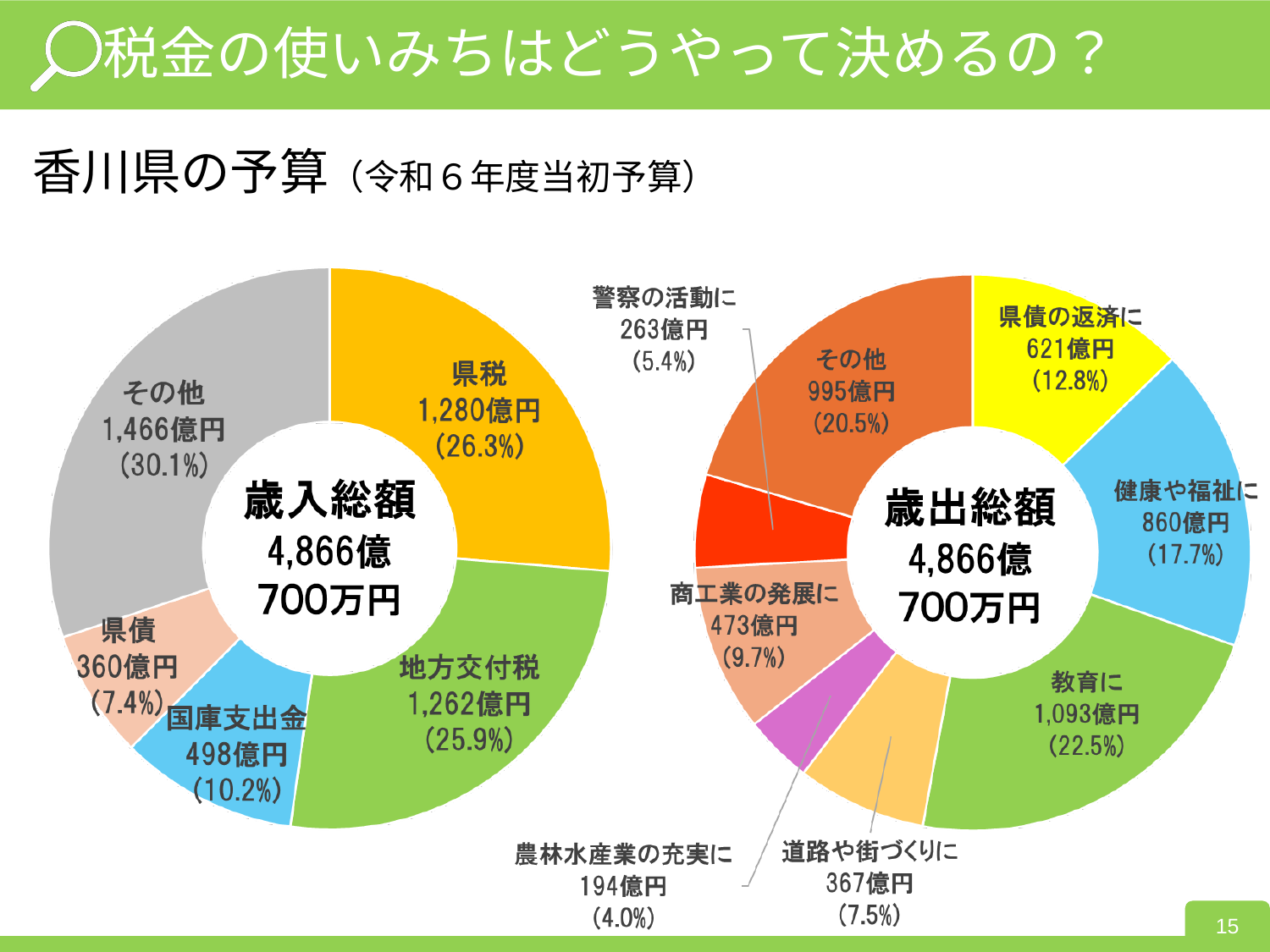
In the 歳入総額 chart on the left, which category has the largest value? その他 In the 歳入総額 chart on the left, what is the value for 県税? 1,280億円 In the 歳入総額 chart on the left, which category has the smallest value? 県債 In the 歳出総額 chart on the right, which category has the smallest value? 農林水産業の充実に In the 歳出総額 chart on the right, what is the value for 教育に? 1,093億円 In the 歳入総額 chart on the left, what is the difference between 国庫支出金 and 県債? 138億円 What kind of chart is used for the 歳入総額 on the left? Donut (pie) chart In the 歳出総額 chart on the right, which is larger, 県債の返済に or 商工業の発展に? 県債の返済に In the 歳出総額 chart on the right, what share of the total does 健康や福祉に represent? 17.7% In the 歳入総額 chart on the left, how many categories are shown? 5 In the 歳入総額 chart on the left, what share of the total does 地方交付税 represent? 25.9% In the 歳出総額 chart on the right, how many categories are shown? 8